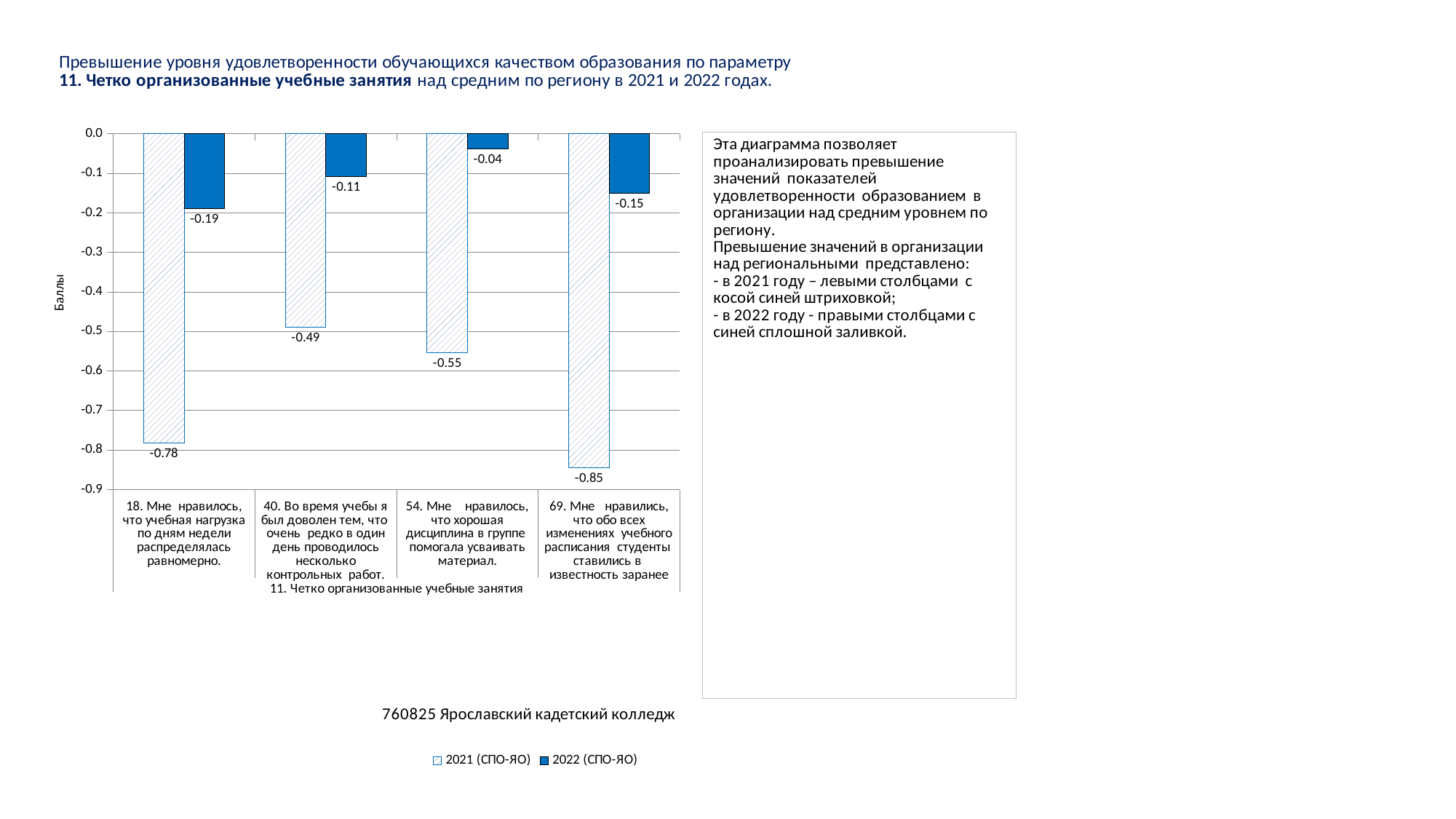
Which category has the lowest 2021 (СПО-ЯО) value? 69. Мне нравились, что обо всех изменениях учебного расписания студенты ставились в известность заранее How many series does the legend list? 2 What kind of chart is shown on the slide? Bar chart How many categories are shown on the x axis of the chart? 4 What is the 2021 (СПО-ЯО) value for category 40 (Во время учебы я был доволен тем, что очень редко в один день проводилось несколько контрольных работ)? -0.49 What is the 2022 (СПО-ЯО) value for category 54 (Мне нравилось, что хорошая дисциплина в группе помогала усваивать материал)? -0.04 What is the 2021 (СПО-ЯО) value for category 18 (Мне нравилось, что учебная нагрузка по дням недели распределялась равномерно)? -0.78 Which category has the highest 2022 (СПО-ЯО) value? 54. Мне нравилось, что хорошая дисциплина в группе помогала усваивать материал Which is larger: the 2022 value for category 18 or the 2022 value for category 69? Category 69 (-0.15) What is the difference between the 2021 values for category 69 and category 40? 0.36 Is the 2021 value for category 54 greater or less than -0.5? less What is the difference between the 2021 and 2022 values for category 18? 0.59